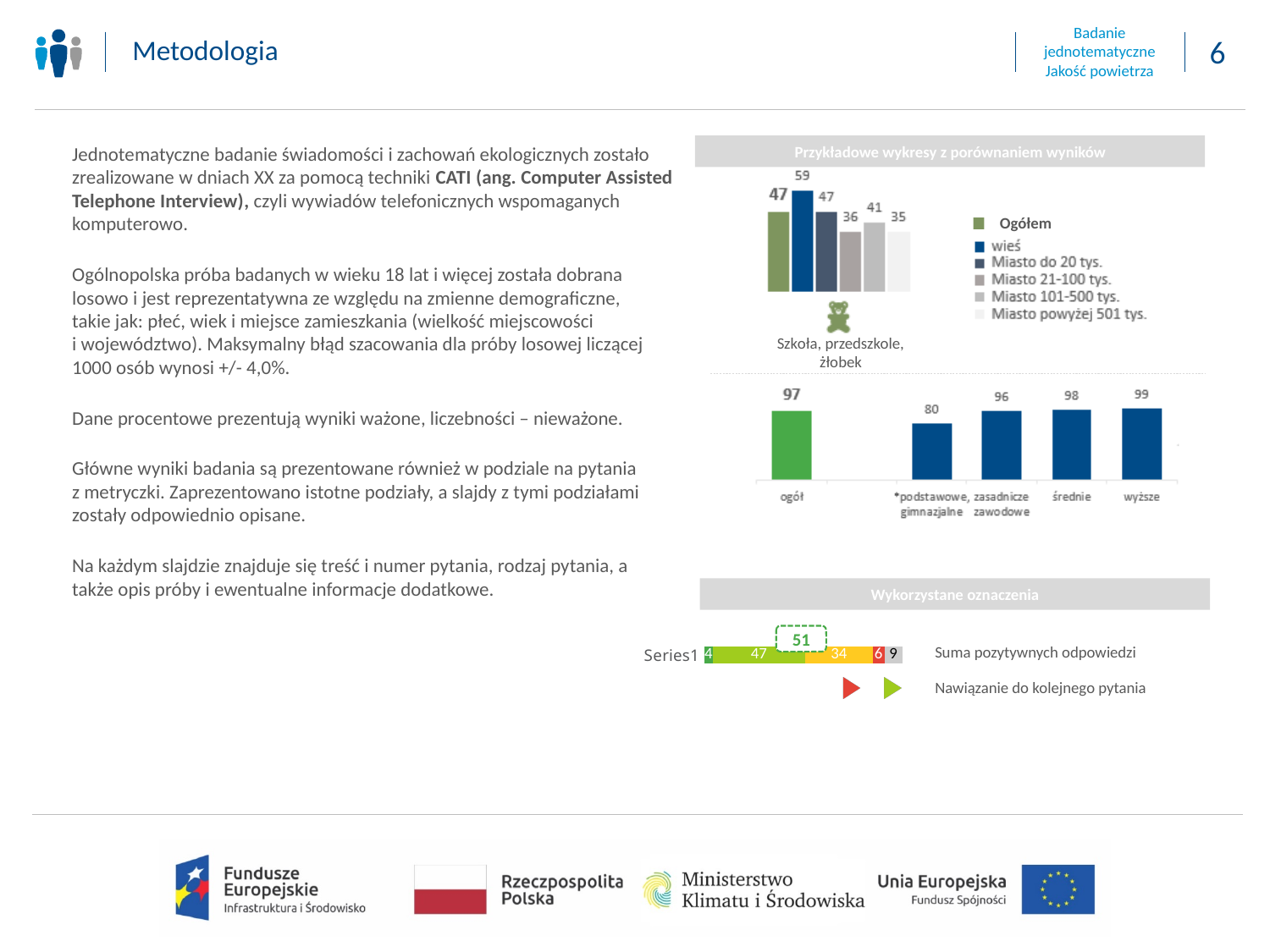
In the top-right chart labelled 'Szkoła, przedszkole, żłobek', how many series does the legend list? 6 In the middle chart on the right (with categories ogół, podstawowe, zasadnicze zawodowe, średnie, wyższe), what is the value for 'ogół'? 97 In the middle chart on the right, what is the difference between the values for 'wyższe' and 'podstawowe, gimnazjalne'? 19 In the middle chart on the right, which category has the lowest value? podstawowe, gimnazjalne In the top-right chart labelled 'Szkoła, przedszkole, żłobek', what is the value for 'wieś'? 59 In the top-right chart labelled 'Szkoła, przedszkole, żłobek', what is the difference between the values for 'wieś' and 'Miasto powyżej 501 tys.'? 24 In the top-right chart labelled 'Szkoła, przedszkole, żłobek', what is the value for 'Ogółem'? 47 In the top-right chart labelled 'Szkoła, przedszkole, żłobek', which series has the lowest value? Miasto powyżej 501 tys. In the middle chart on the right, which category has the highest value? wyższe In the top-right chart labelled 'Szkoła, przedszkole, żłobek', which series has the highest value? wieś In the bottom stacked bar chart labelled 'Series1', what is the value of the largest segment? 47 In the middle chart on the right, how many categories are shown? 5